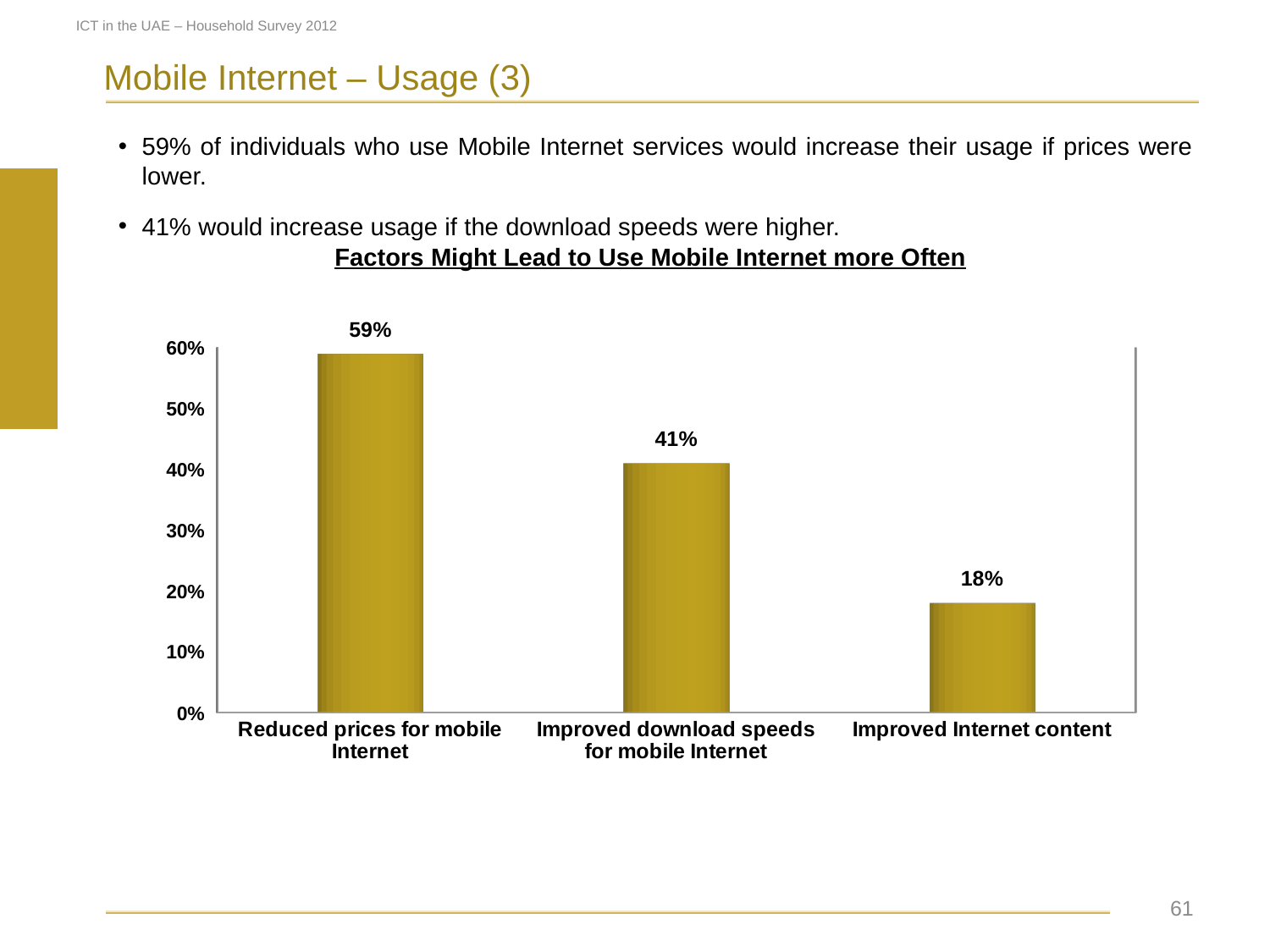
How many categories are shown in the chart? 3 What kind of chart is shown on the slide? bar chart What is the difference between the values for Reduced prices for mobile Internet and Improved download speeds for mobile Internet? 18% Which factor has the lowest value? Improved Internet content What is the value for Improved download speeds for mobile Internet? 41% What is the difference between the values for Improved download speeds for mobile Internet and Improved Internet content? 23% Is the value for Improved Internet content greater or less than 20%? less Which factor has the highest value? Reduced prices for mobile Internet What is the value for Reduced prices for mobile Internet? 59% Which is larger, the value for Improved download speeds for mobile Internet or the value for Improved Internet content? Improved download speeds for mobile Internet What is the title of the chart? Factors Might Lead to Use Mobile Internet more Often What is the value for Improved Internet content? 18%